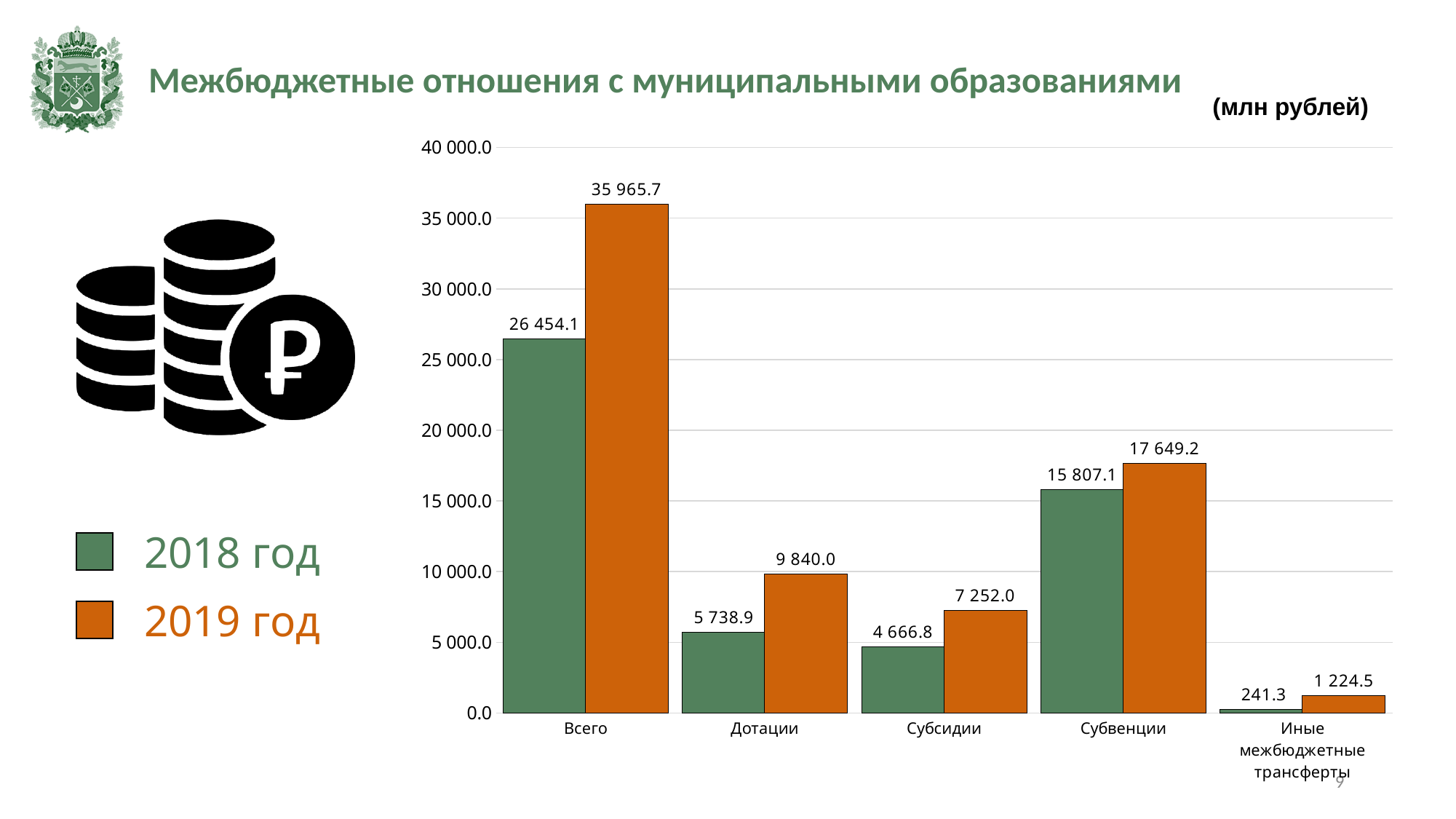
What is the difference between the 2019 год and 2018 год values for Субвенции? 1 842.1 What is the value for Иные межбюджетные трансферты in 2019 год? 1 224.5 What is the value for Всего in 2019 год? 35 965.7 What is the difference between the 2019 год and 2018 год values for Всего? 9 511.6 Excluding Всего, which category has the highest value in 2019 год? Субвенции How many series does the legend list? 2 What is the value for Субсидии in 2018 год? 4 666.8 What kind of chart is shown on the slide? Bar chart Which category has the lowest value in 2018 год? Иные межбюджетные трансферты How many categories are shown on the x axis? 5 Which is larger for Дотации: the 2018 год value or the 2019 год value? 2019 год What is the value for Дотации in 2018 год? 5 738.9